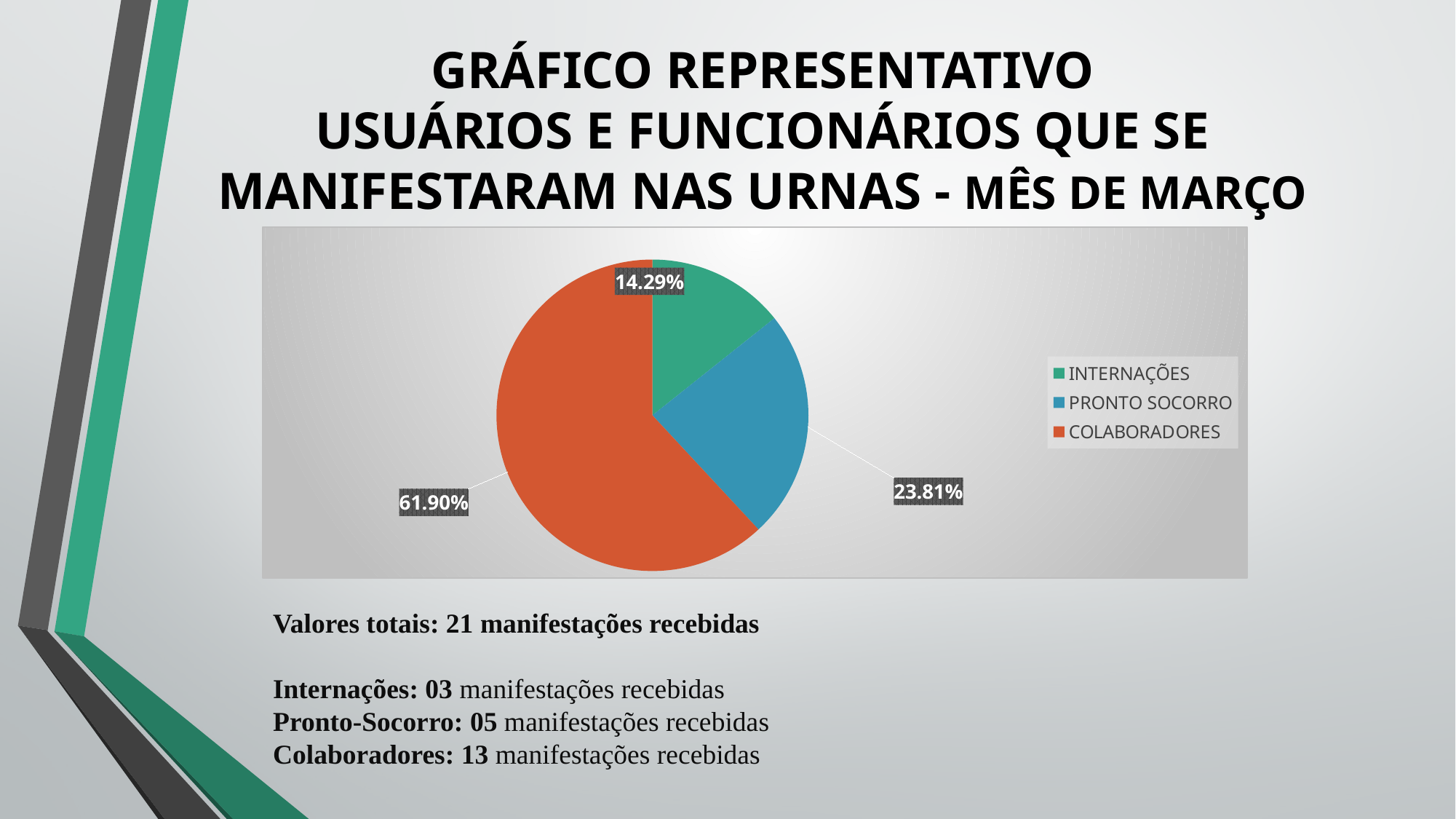
What kind of chart is shown on the slide? pie chart What share of the pie does INTERNAÇÕES represent? 14.29% What share of the pie does PRONTO SOCORRO represent? 23.81% What share of the pie does COLABORADORES represent? 61.90% Which category has the largest slice of the pie? COLABORADORES Which category has the smallest slice of the pie? INTERNAÇÕES What colour is the COLABORADORES slice? orange How many entries does the legend list? 3 What is the difference in percentage points between the COLABORADORES slice and the PRONTO SOCORRO slice? 38.09 How many slices does the pie chart have? 3 What colour is the PRONTO SOCORRO slice? blue Which slice is larger, PRONTO SOCORRO or INTERNAÇÕES? PRONTO SOCORRO